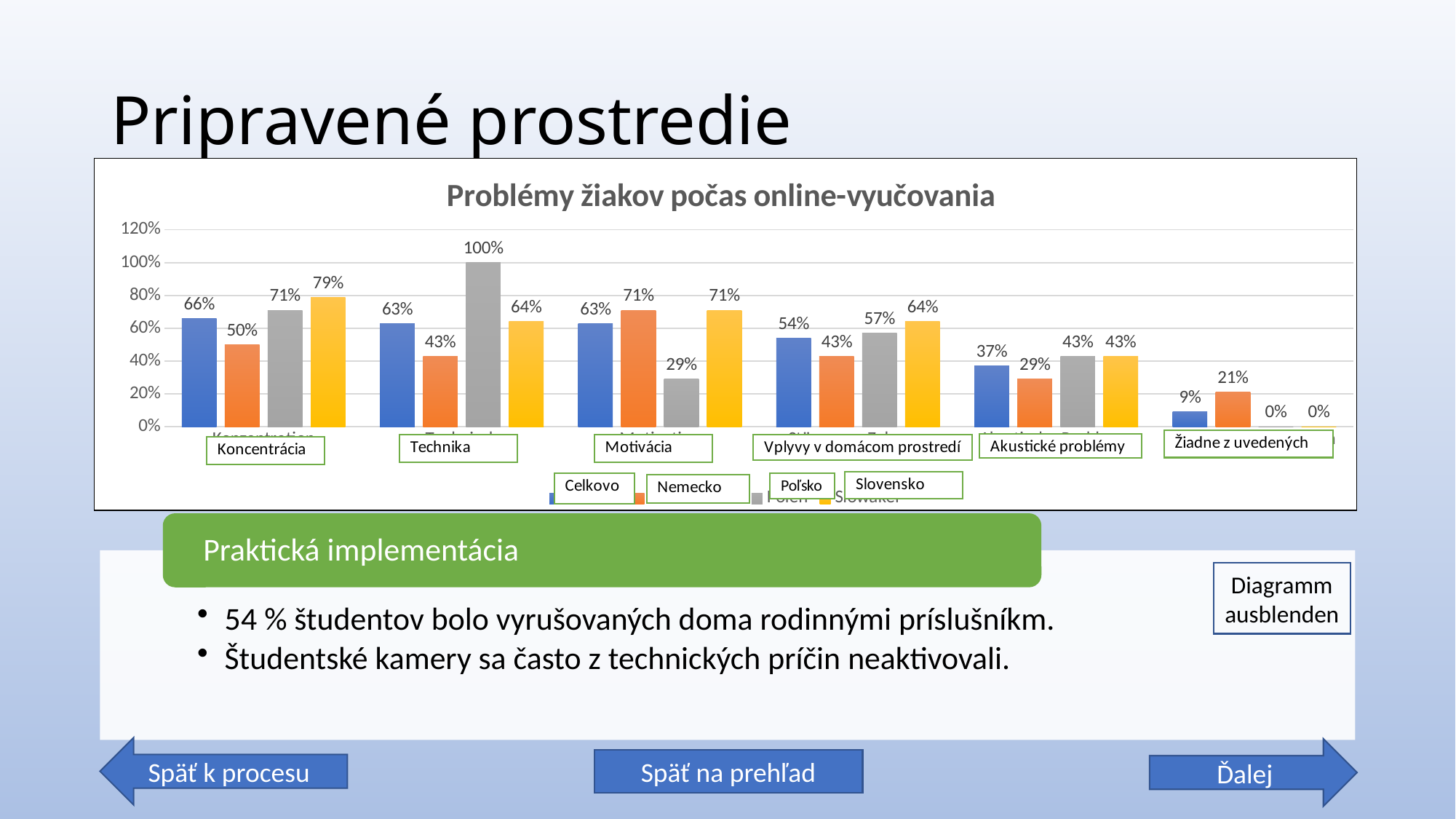
In the Motivácia category, which is larger: the value for Nemecko or the value for Poľsko? Nemecko Which category has the lowest value for the Poľsko series? Žiadne z uvedených Which category has the highest value for the Celkovo series? Koncentrácia How many categories are shown on the x axis? 6 What is the value for Nemecko in the Žiadne z uvedených category? 21% What is the difference between the Poľsko and Nemecko values in the Technika category? 57% What is the value for Slovensko in the Koncentrácia category? 79% What is the value for Poľsko in the Technika category? 100% What is the value for Celkovo in the Vplyvy v domácom prostredí category? 54% What kind of chart is shown on the slide? bar chart What is the title of the chart? Problémy žiakov počas online-vyučovania How many series does the legend list? 4